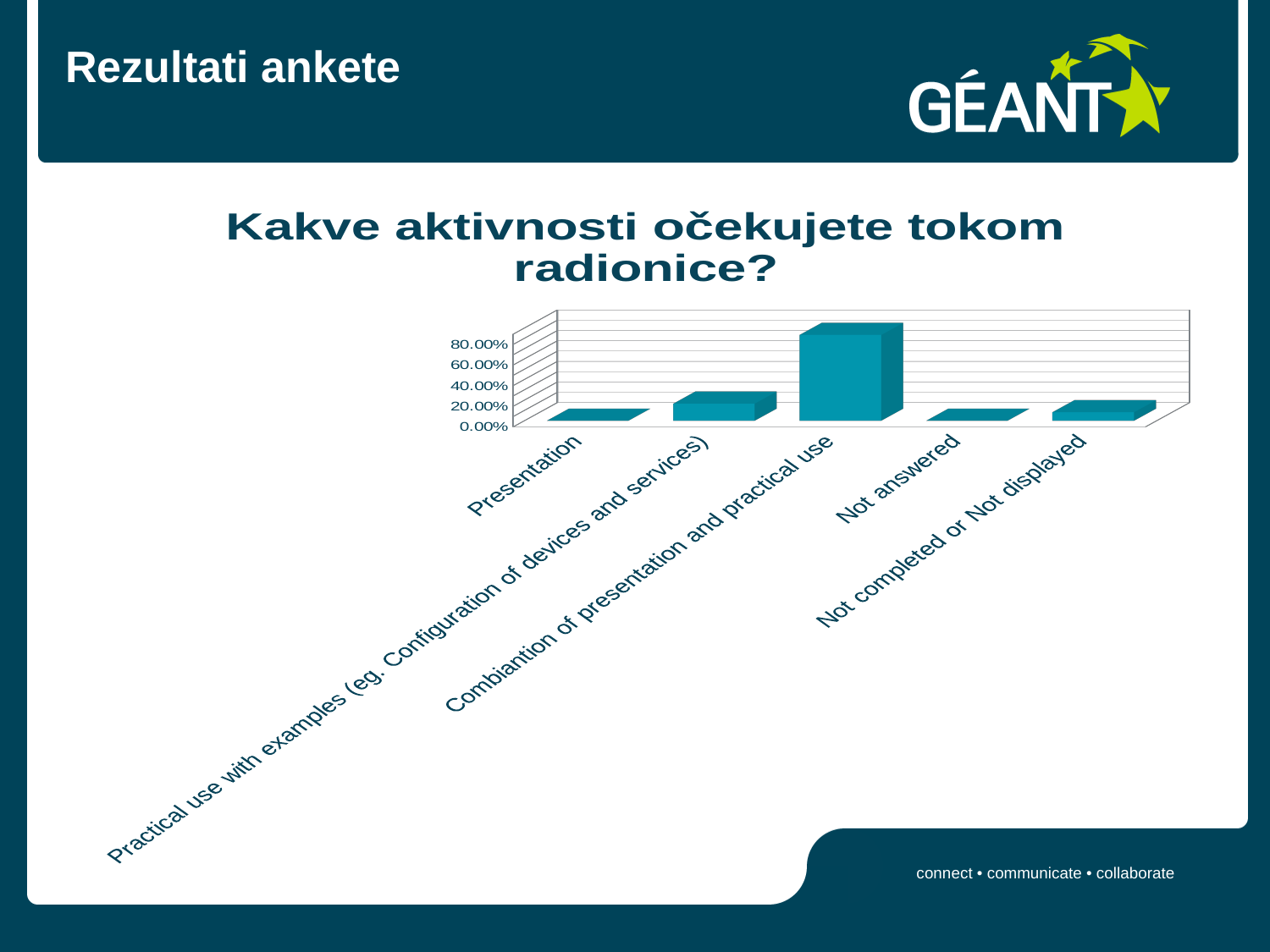
Which is larger, the value for Practical use with examples (eg. Configuration of devices and services) or the value for Not answered? Practical use with examples (eg. Configuration of devices and services) Is the value for Not completed or Not displayed greater or less than 40.00%? less Which category has the highest value in the chart? Combiantion of presentation and practical use Is the value for Presentation greater or less than 20.00%? less What kind of chart is shown on the slide? bar chart What is the title of the chart? Kakve aktivnosti očekujete tokom radionice? What is the highest value labelled on the vertical axis of the chart? 80.00% Which is larger, the value for Combiantion of presentation and practical use or the value for Practical use with examples (eg. Configuration of devices and services)? Combiantion of presentation and practical use Is the value for Practical use with examples (eg. Configuration of devices and services) greater or less than 40.00%? less How many categories are shown on the x axis of the chart? 5